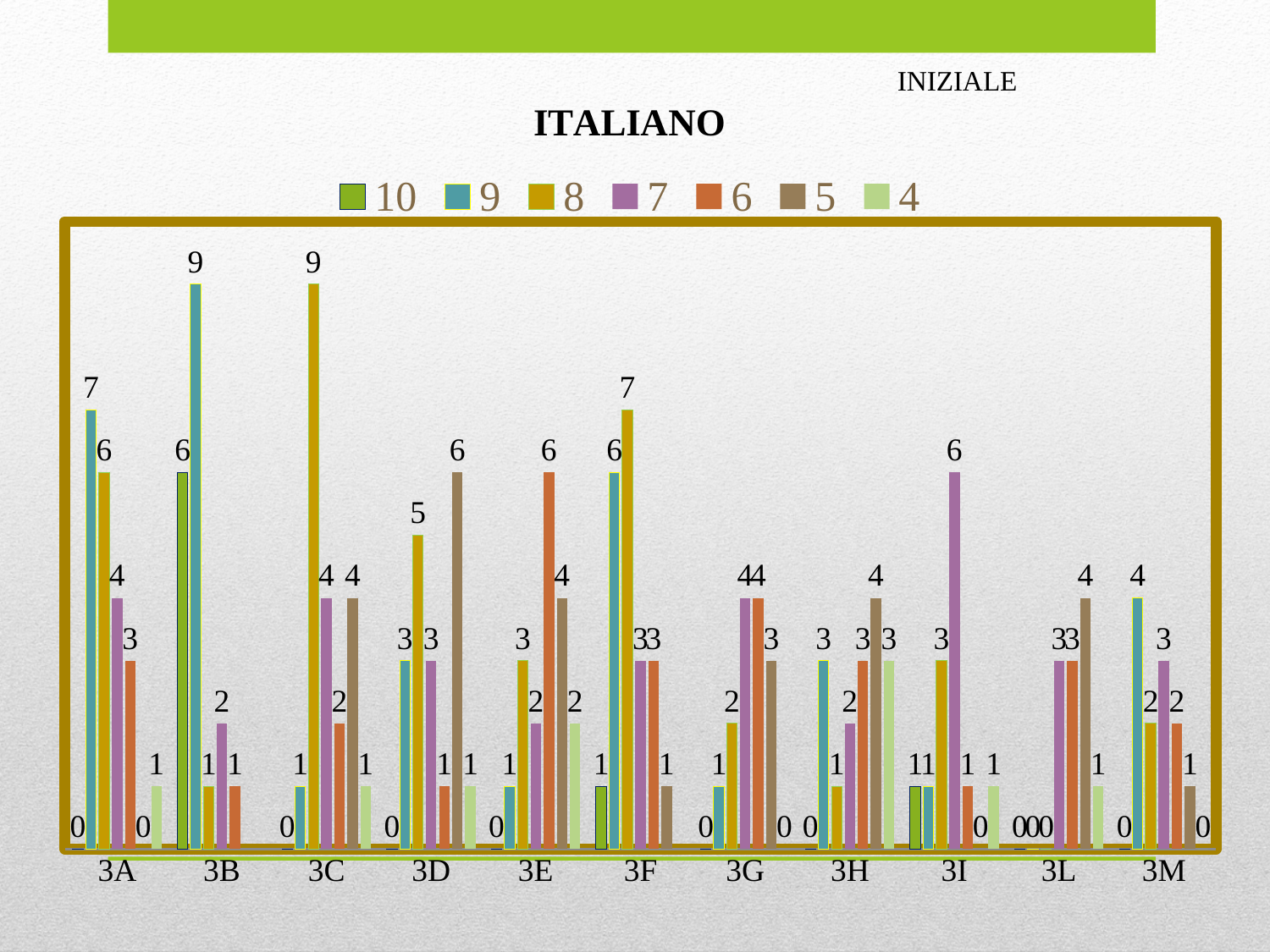
What is the difference between series 9 and series 8 for category 3A? 1 What is the value of series 8 for category 3C? 9 What is the value of series 9 for category 3A? 7 How many categories are shown on the x axis? 11 What kind of chart is shown on the slide? bar chart Which category has the larger value for series 9, 3B or 3F? 3B How many series does the legend list? 7 What is the value of series 5 for category 3D? 6 What is the title of the chart? ITALIANO What is the value of series 6 for category 3E? 6 Which category has the highest value for series 8? 3C What is the value of series 7 for category 3I? 6